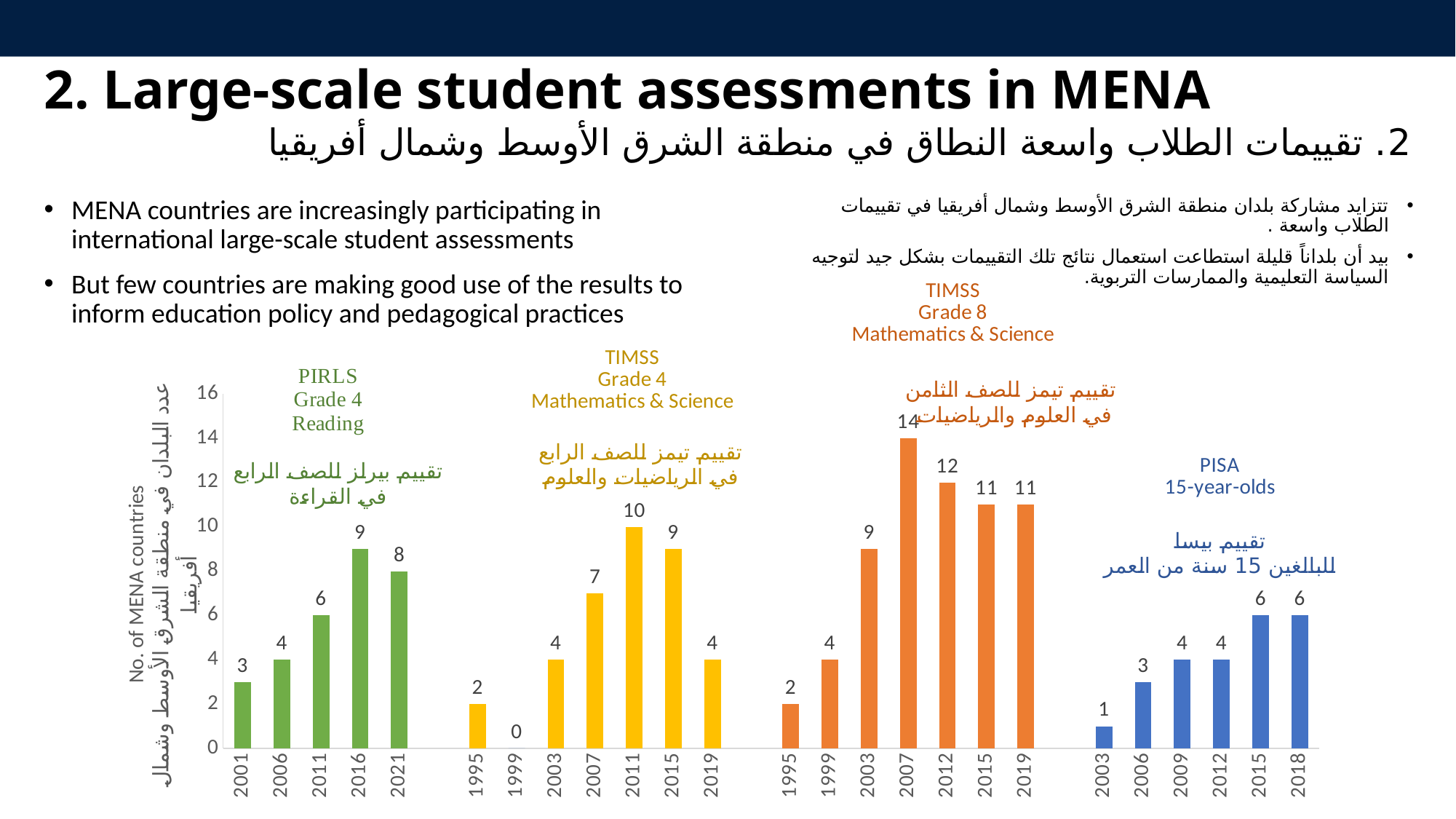
Do the PISA values rise or fall from 2003 to 2018? Rise How many MENA countries participated in TIMSS Grade 4 Mathematics & Science in 1999? 0 What is the label of the vertical axis of the chart? No. of MENA countries What is the difference between the number of MENA countries in TIMSS Grade 8 in 2007 and in 2012? 2 How many MENA countries participated in PISA in 2018? 6 Which year has the lowest number of MENA countries participating in PISA? 2003 Which had more MENA countries participating: PIRLS in 2021 or TIMSS Grade 4 in 2015? TIMSS Grade 4 in 2015 What type of chart is shown on the slide? Bar chart Which year has the highest number of MENA countries participating in TIMSS Grade 4 Mathematics & Science? 2011 How many MENA countries participated in TIMSS Grade 8 Mathematics & Science in 2007? 14 How many years are shown on the x axis for TIMSS Grade 8 Mathematics & Science? 7 How many MENA countries participated in PIRLS Grade 4 Reading in 2016? 9